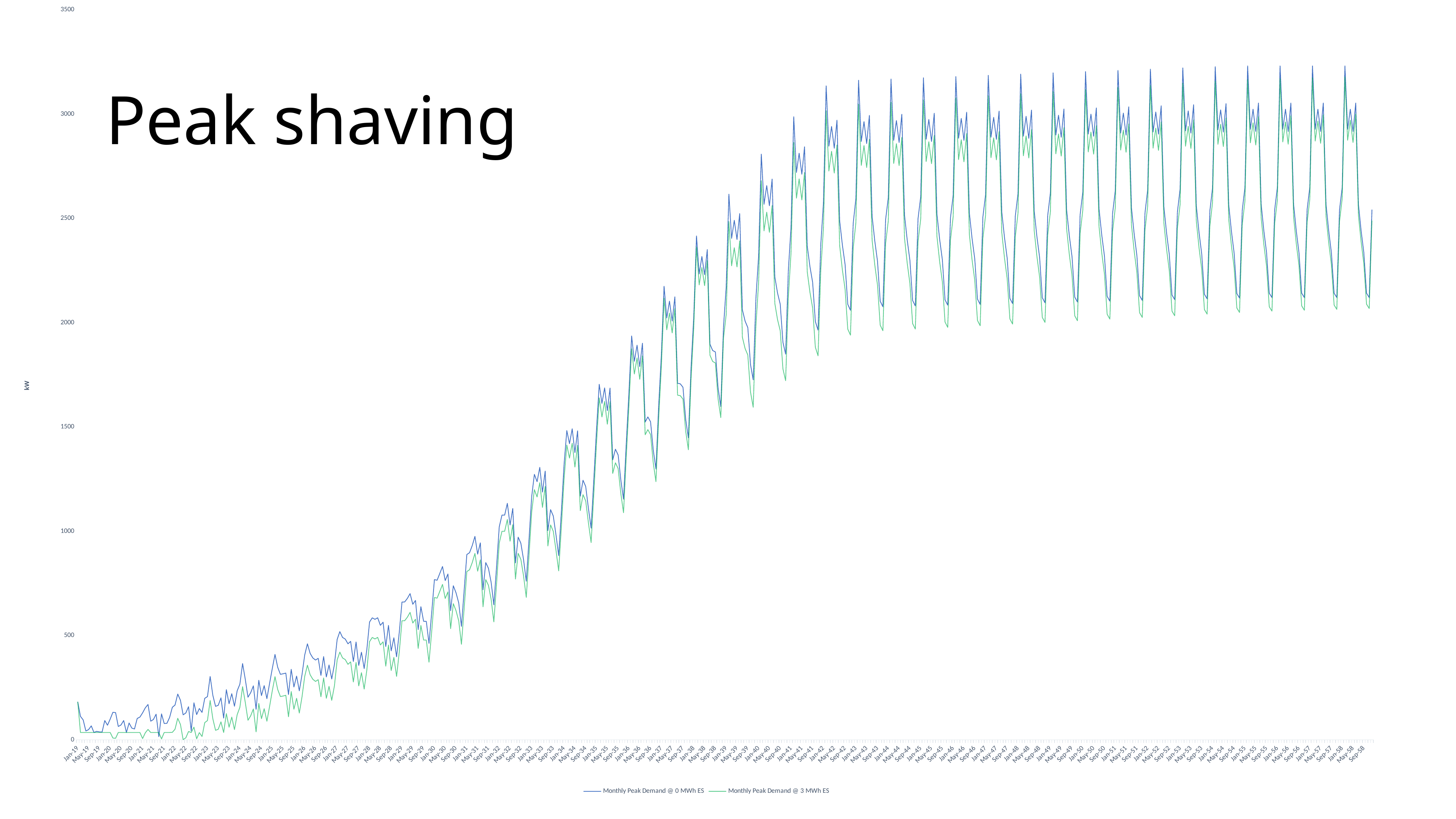
At the Jan-50 peak, which series is higher: Monthly Peak Demand @ 0 MWh ES or Monthly Peak Demand @ 3 MWh ES? Monthly Peak Demand @ 0 MWh ES Is the value for Monthly Peak Demand @ 3 MWh ES at Sep-22 greater or less than 500? less What kind of chart is shown on the slide? line chart Is the peak value for Monthly Peak Demand @ 0 MWh ES around Jan-57 greater or less than 3000? greater How many series does the legend list? 2 Which series is drawn in green? Monthly Peak Demand @ 3 MWh ES Is the value for Monthly Peak Demand @ 3 MWh ES at Jan-30 greater or less than 1000? less What unit is shown on the vertical axis label? kW Do the monthly peak demand values generally rise or fall from Jan-19 to Jan-58? rise What is the title of the slide? Peak shaving